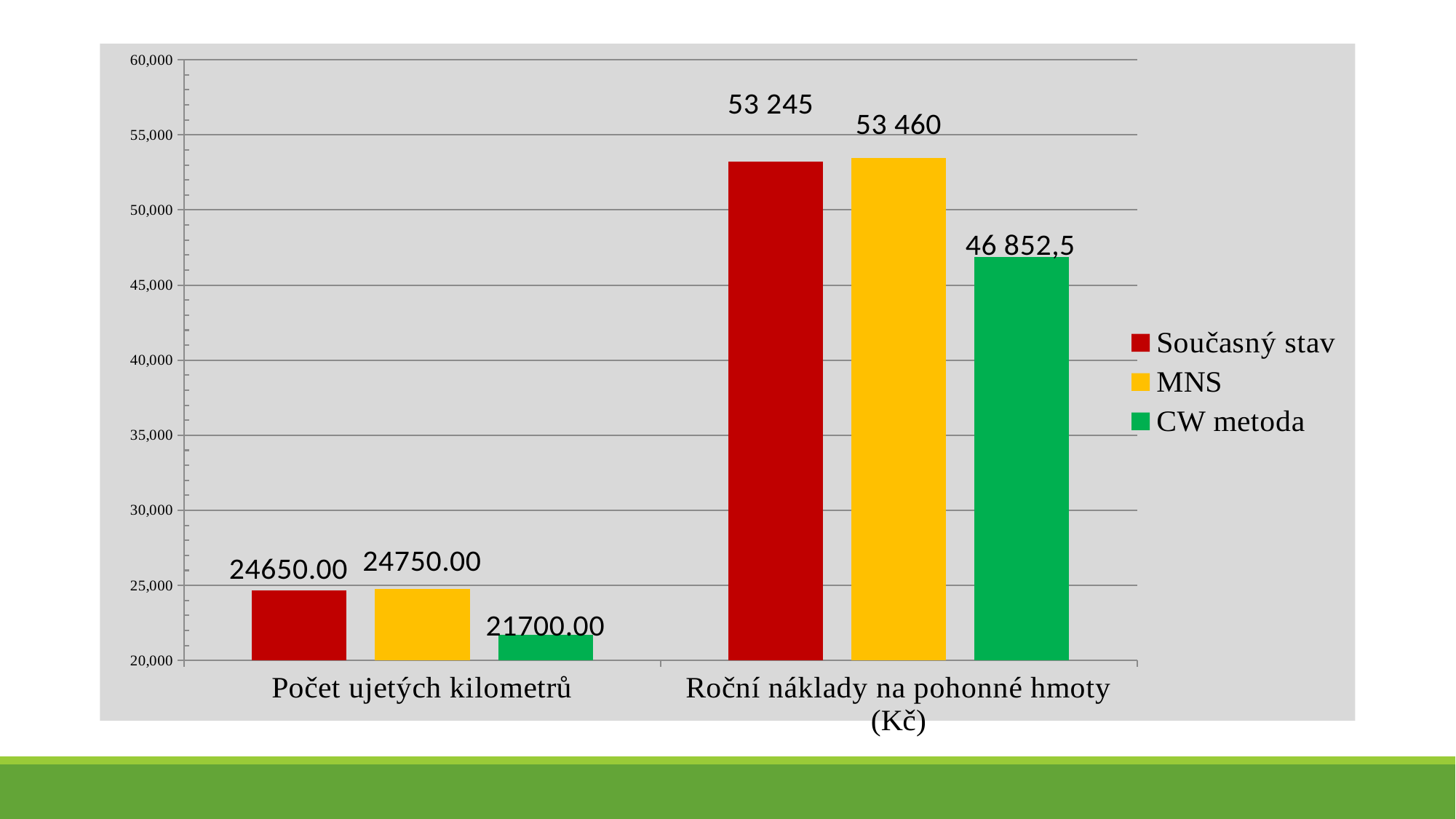
What is the value for Současný stav in the Počet ujetých kilometrů category? 24650.00 What is the value for CW metoda in the Počet ujetých kilometrů category? 21700.00 What is the value for CW metoda in the Roční náklady na pohonné hmoty (Kč) category? 46 852,5 Which is larger in the Počet ujetých kilometrů category: the value for MNS or the value for Současný stav? MNS Which series has the highest value in the Roční náklady na pohonné hmoty (Kč) category? MNS What is the value for MNS in the Roční náklady na pohonné hmoty (Kč) category? 53 460 How many series does the legend list? 3 What is the difference between the MNS and Současný stav values in the Roční náklady na pohonné hmoty (Kč) category? 215 What kind of chart is shown on the slide? bar chart Which series has the lowest value in the Počet ujetých kilometrů category? CW metoda How many categories are shown on the x axis? 2 Which colour represents the CW metoda series? green